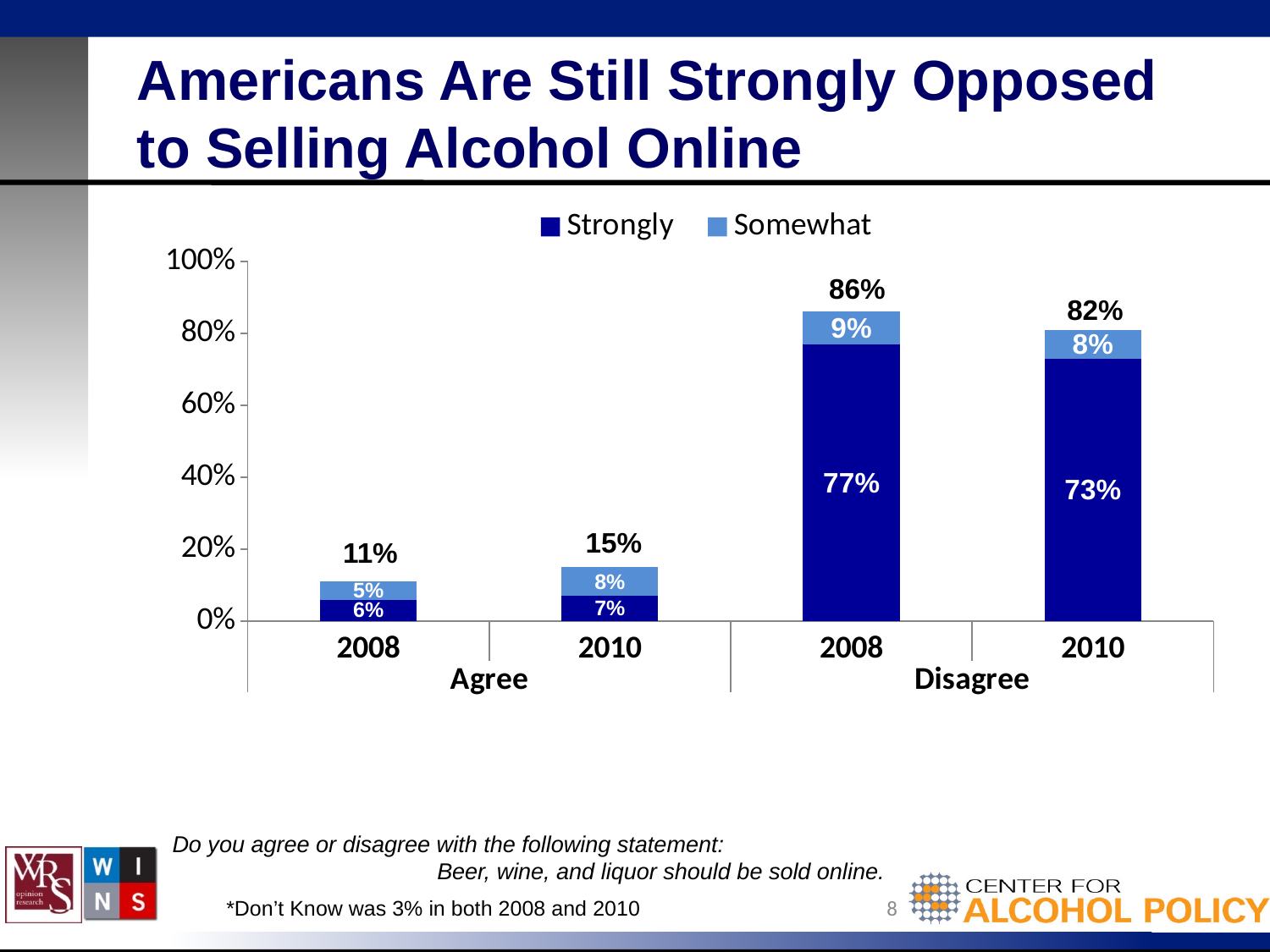
What is the Somewhat value for Agree in 2010? 8% What is the Strongly value for Disagree in 2008? 77% What is the total of the stacked bar for Disagree in 2010? 82% Is the total for Disagree in 2010 greater or less than 80%? greater How many bars are plotted in the chart? 4 What is the total of the stacked bar for Agree in 2008? 11% What kind of chart is shown on the slide? Stacked bar chart Which bar has the lowest total? Agree 2008 Which is larger, the Somewhat value for Disagree in 2008 or the Somewhat value for Disagree in 2010? Disagree 2008 How many series does the legend list? 2 What is the difference between the Strongly values for Disagree in 2008 and Disagree in 2010? 4% Which bar has the highest total? Disagree 2008